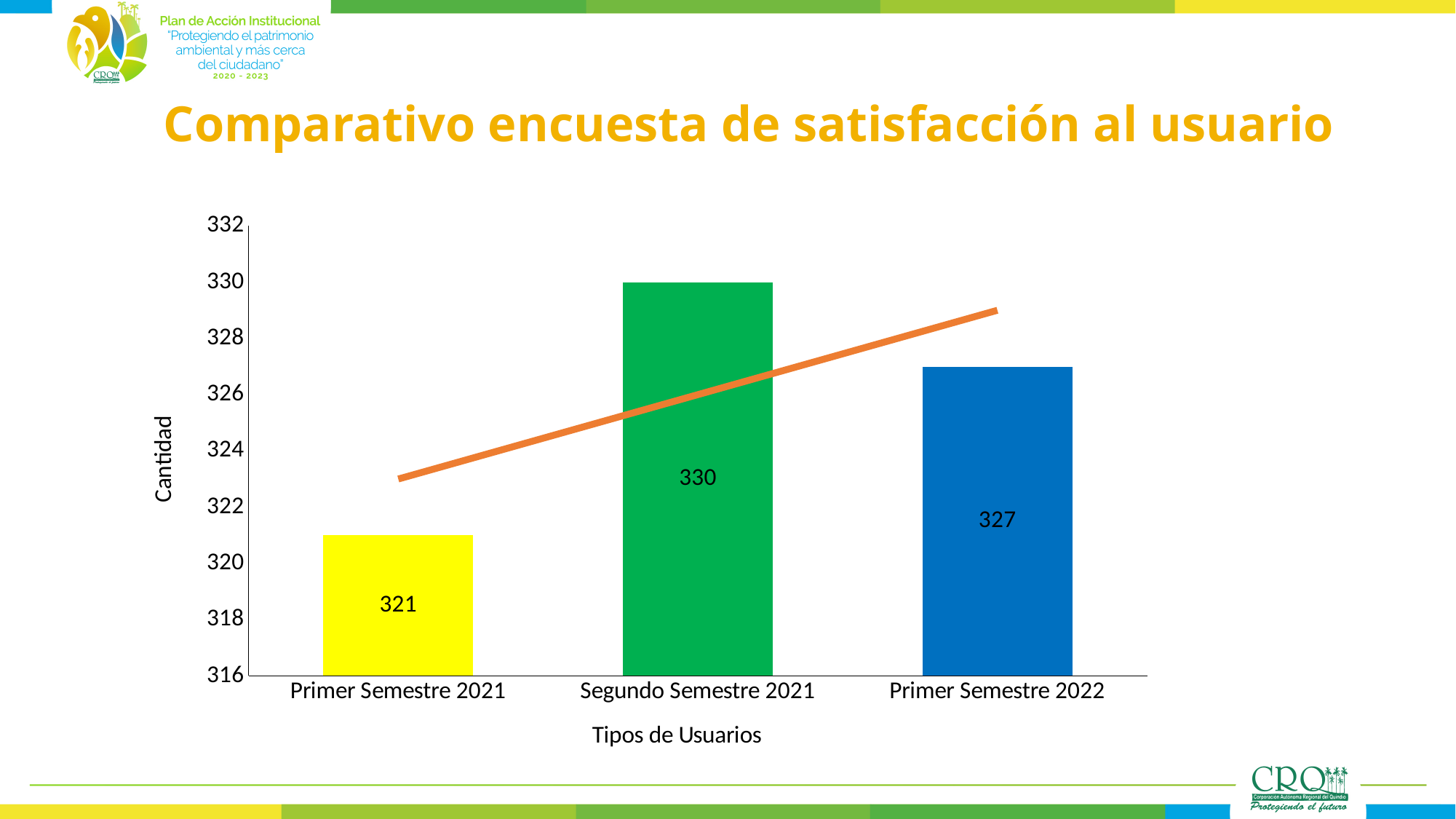
Which is larger, the value for Primer Semestre 2022 or the value for Primer Semestre 2021? Primer Semestre 2022 Which category has the lowest value? Primer Semestre 2021 What is the difference between the values for Segundo Semestre 2021 and Primer Semestre 2022? 3 What is the value for Segundo Semestre 2021? 330 How many categories are shown on the x axis? 3 What kind of chart is shown on the slide? bar chart Which category has the highest value? Segundo Semestre 2021 Is the value for Primer Semestre 2022 greater or less than 326? greater What is the label of the y axis? Cantidad What is the value for Primer Semestre 2021? 321 What is the difference between the values for Segundo Semestre 2021 and Primer Semestre 2021? 9 What is the value for Primer Semestre 2022? 327